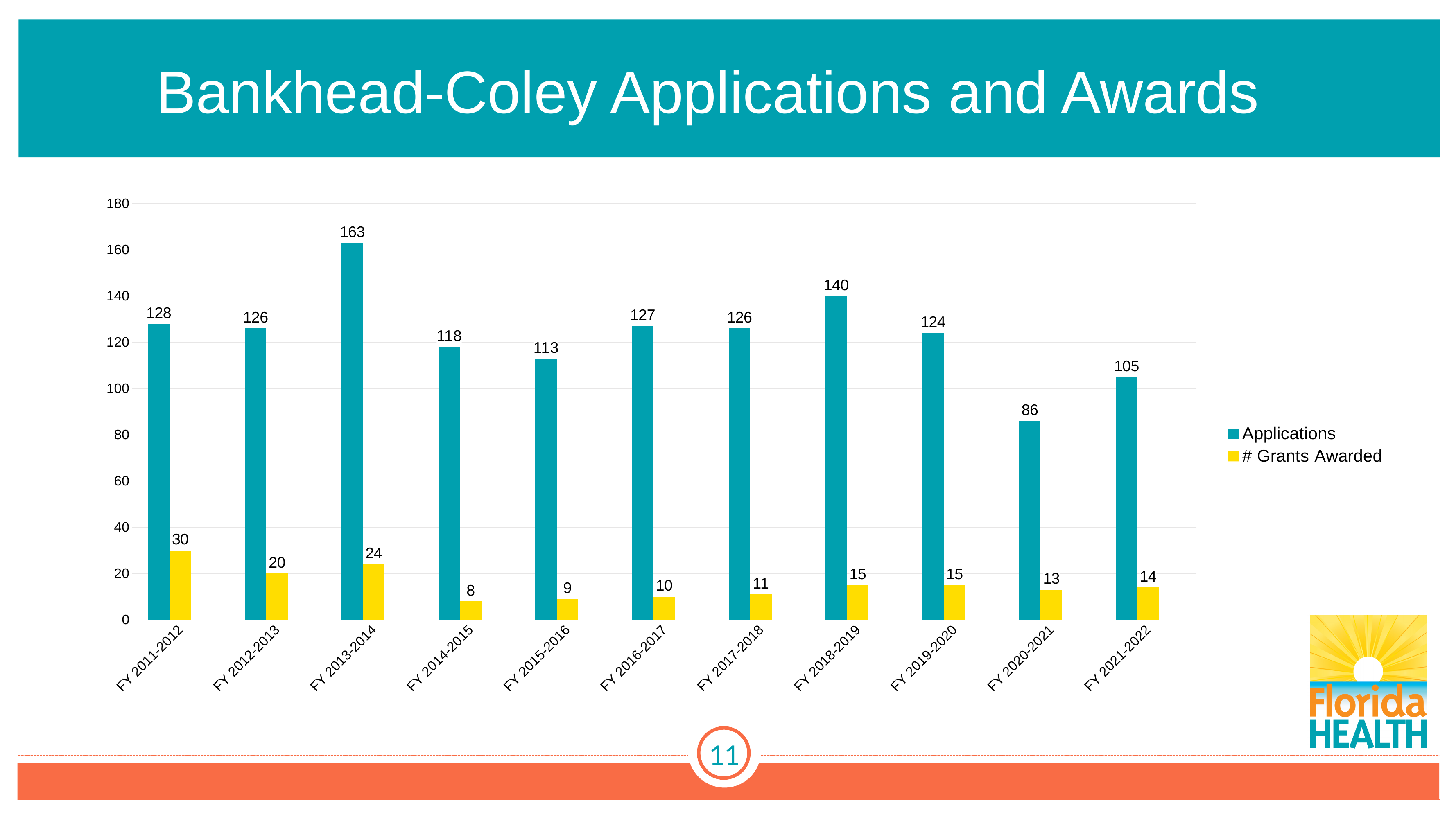
Which fiscal year had the highest number of Applications? FY 2013-2014 What kind of chart is shown on the slide? Bar chart How many Applications were there in FY 2013-2014? 163 What is the difference in Applications between FY 2013-2014 and FY 2020-2021? 77 Which fiscal year had more Applications, FY 2016-2017 or FY 2021-2022? FY 2016-2017 What is the difference between Applications and # Grants Awarded in FY 2018-2019? 125 Which colour represents # Grants Awarded in the chart? Yellow How many grants were awarded in FY 2014-2015? 8 How many fiscal years are shown on the x axis? 11 Which fiscal year had the lowest number of Applications? FY 2020-2021 How many series does the legend list? 2 Which fiscal year had the highest number of grants awarded? FY 2011-2012